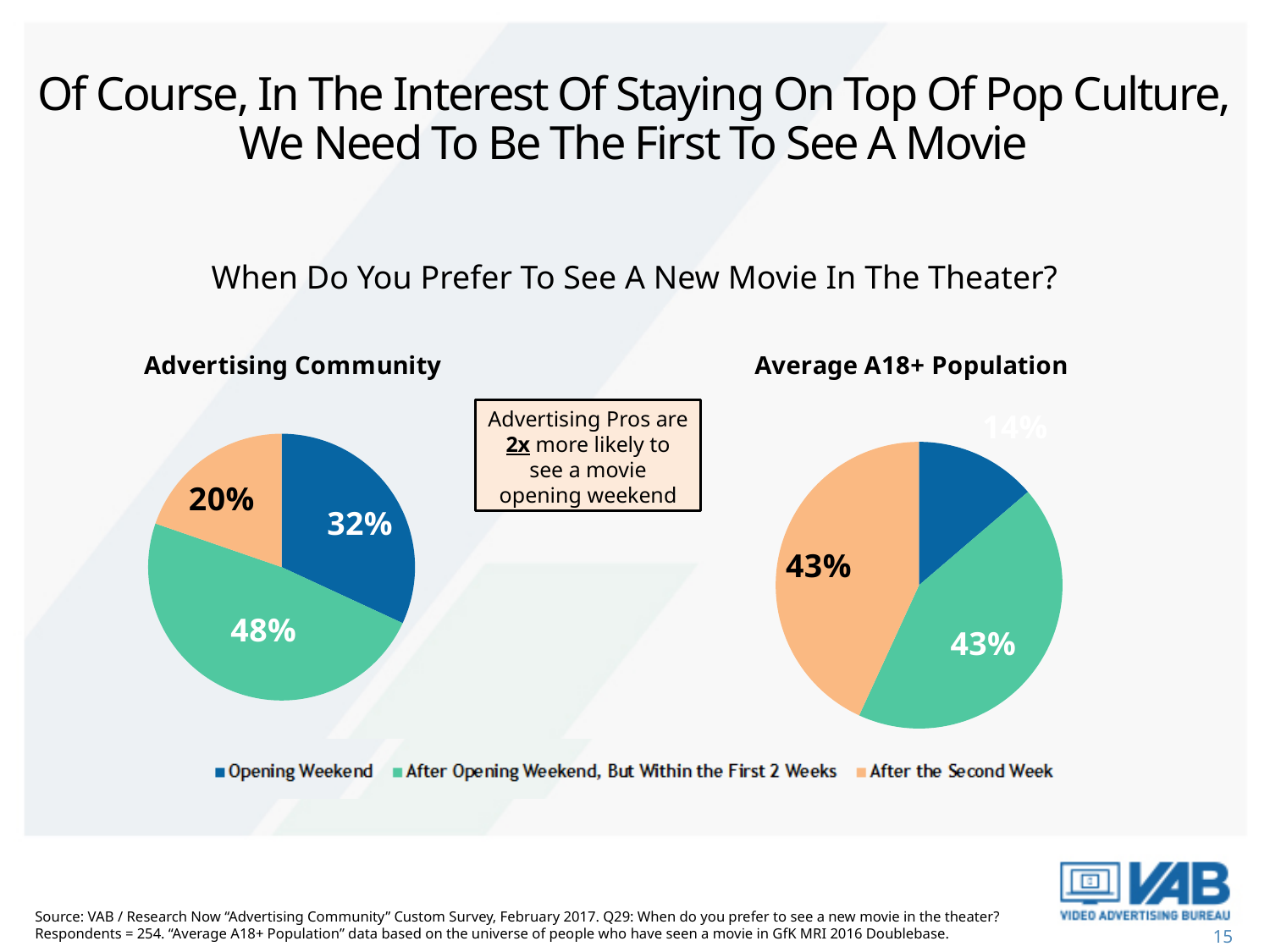
What type of chart is used on this slide? Pie chart In the Average A18+ Population chart, what share prefers After the Second Week? 43% What is the difference between the Opening Weekend share in the Advertising Community chart and the Opening Weekend share in the Average A18+ Population chart? 18 percentage points In the Average A18+ Population chart, what share prefers to see a new movie on Opening Weekend? 14% In the Average A18+ Population chart, which category has the smallest share? Opening Weekend In the Advertising Community chart, which category has the largest share? After Opening Weekend, But Within the First 2 Weeks Which is larger: the Opening Weekend share in the Advertising Community chart or the Opening Weekend share in the Average A18+ Population chart? Advertising Community How many categories does the legend list? 3 In the Advertising Community chart, which category has the smallest share? After the Second Week In the Advertising Community chart, what share prefers to see a new movie on Opening Weekend? 32% In the Advertising Community chart, what share prefers After Opening Weekend, But Within the First 2 Weeks? 48% In the Advertising Community chart, what share prefers After the Second Week? 20%